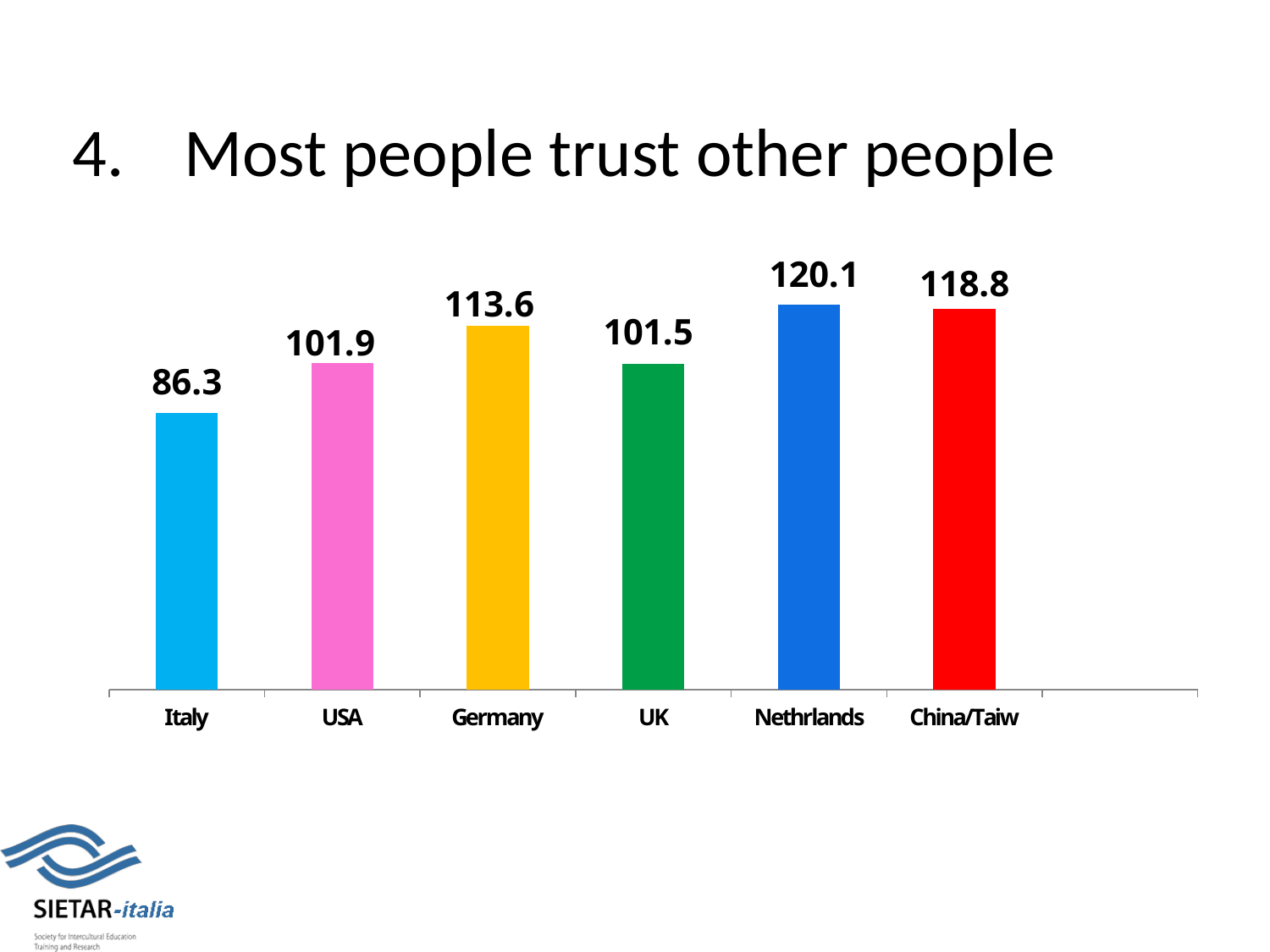
What is the value for Germany? 113.6 Which category has the lowest value? Italy Which is larger, the value for Germany or the value for USA? Germany What is the value for China/Taiw? 118.8 Which category has the highest value? Nethrlands What kind of chart is shown on the slide? bar chart What is the title of the slide? 4. Most people trust other people What is the difference between the values for Germany and UK? 12.1 What is the value for Italy? 86.3 What is the difference between the values for Nethrlands and Italy? 33.8 What is the value for UK? 101.5 How many categories are shown on the x axis? 6